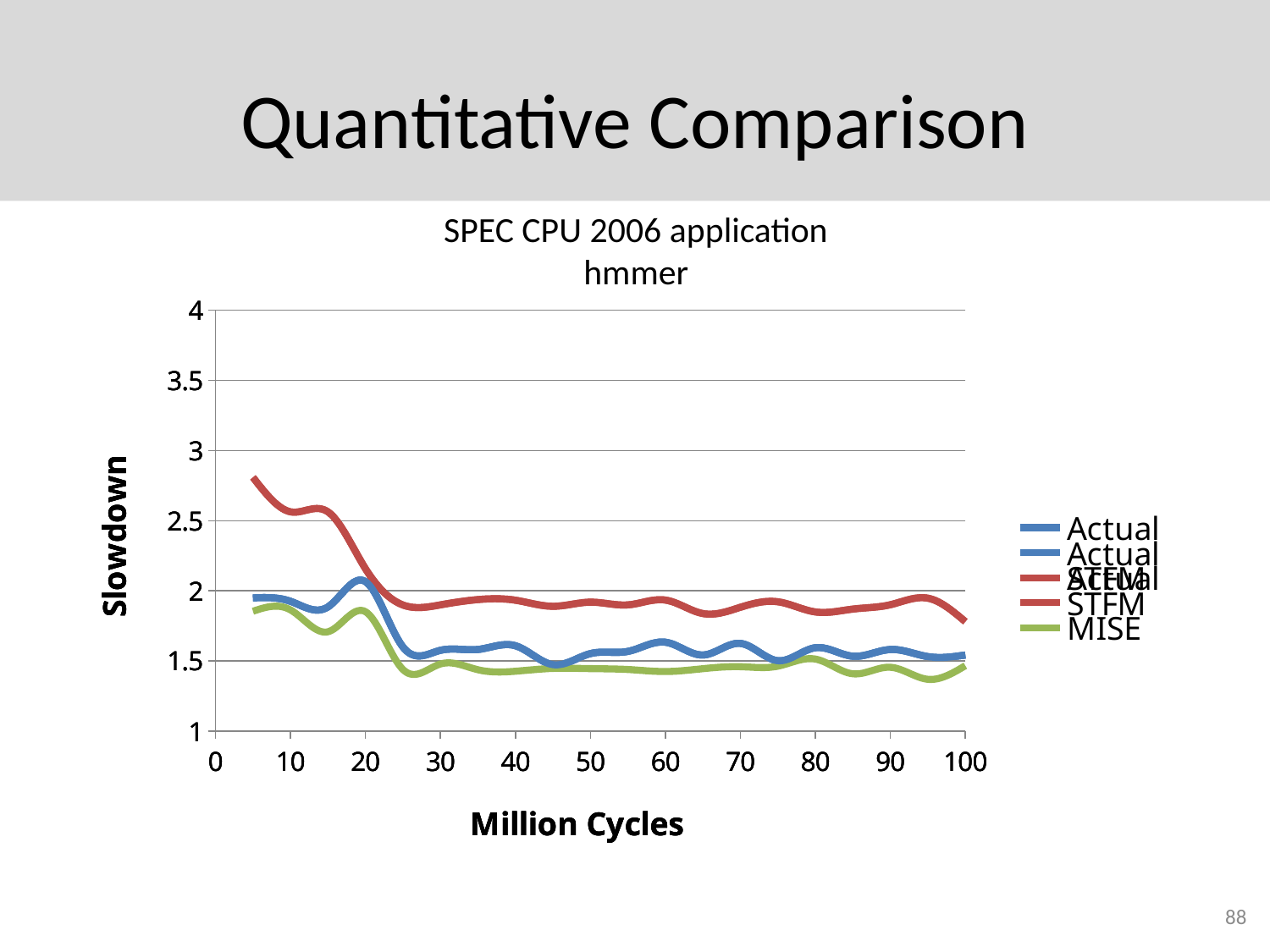
Which series has the highest slowdown values across the chart? STFM Is the Actual value at 60 million cycles greater or less than 1.5? greater What kind of chart is shown on the slide? line chart What is the title of the chart? SPEC CPU 2006 application hmmer Is the STFM value at 50 million cycles greater or less than 2? less What is the label of the y axis? Slowdown Is the STFM value at 5 million cycles greater or less than 2.5? greater Does the STFM line generally rise or fall as million cycles increase from 5 to 100? fall What is the highest value shown on the y axis? 4 Which series has the lowest slowdown values across the chart? MISE At 10 million cycles, which is larger, the STFM value or the Actual value? STFM